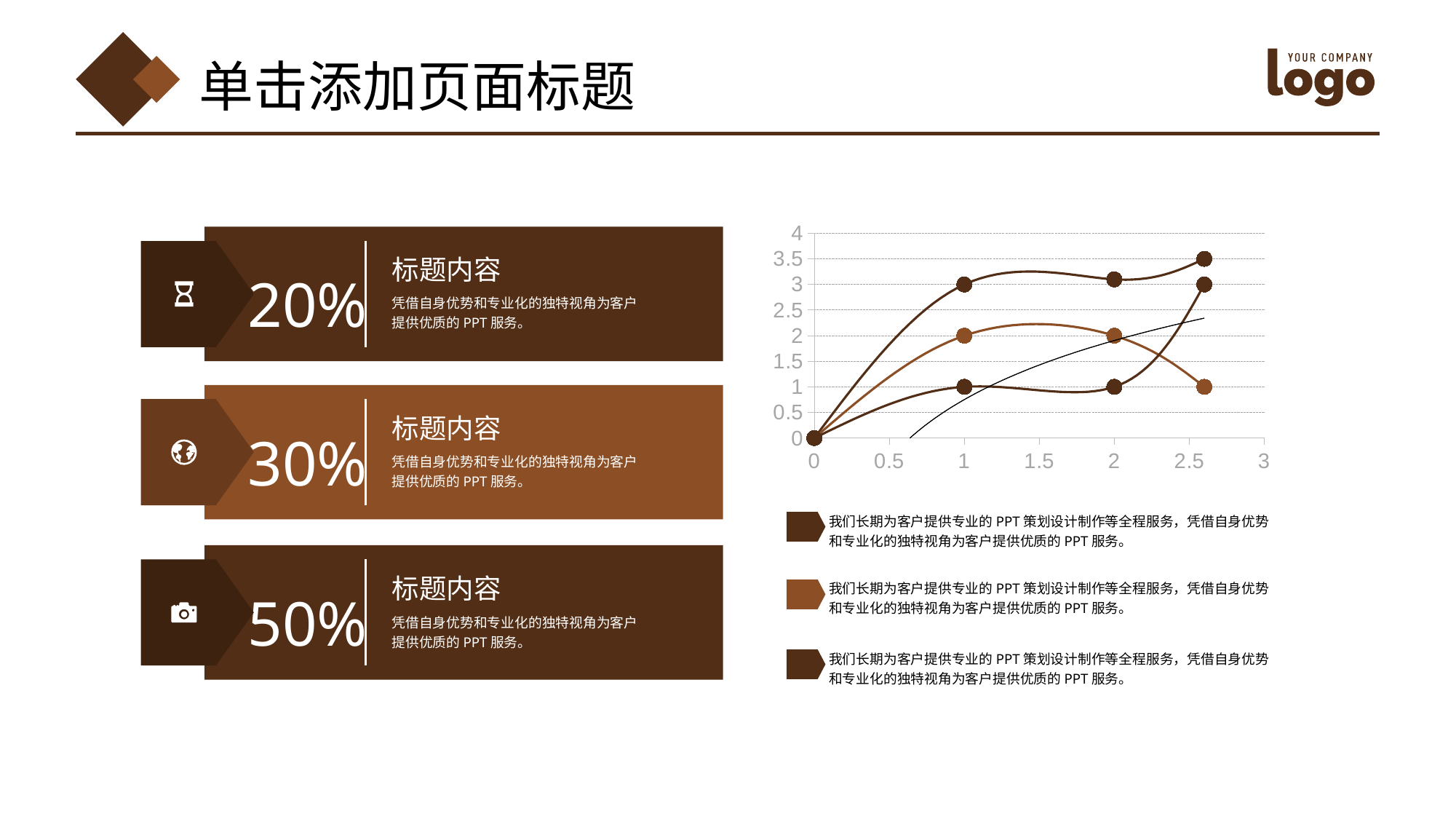
What kind of chart is shown on the right of the slide? line chart At x = 1, what is the value of the highest of the three lines? 3 What is the value of the orange line at x = 1? 2 At x = 1, what is the difference between the highest line and the orange line? 1 At x = 1, what is the value of the lowest of the three lines? 1 What is the highest value on the vertical axis of the chart? 4 What is the highest value on the horizontal axis of the chart? 3 Does the orange line rise or fall between x = 2 and its last point? fall At x = 1, which is larger: the orange line or the lowest dark brown line? the orange line What is the value of the orange line at x = 2? 2 What is the highest value reached by any line on the chart? 3.5 What is the value of the last (rightmost) point of the orange line? 1